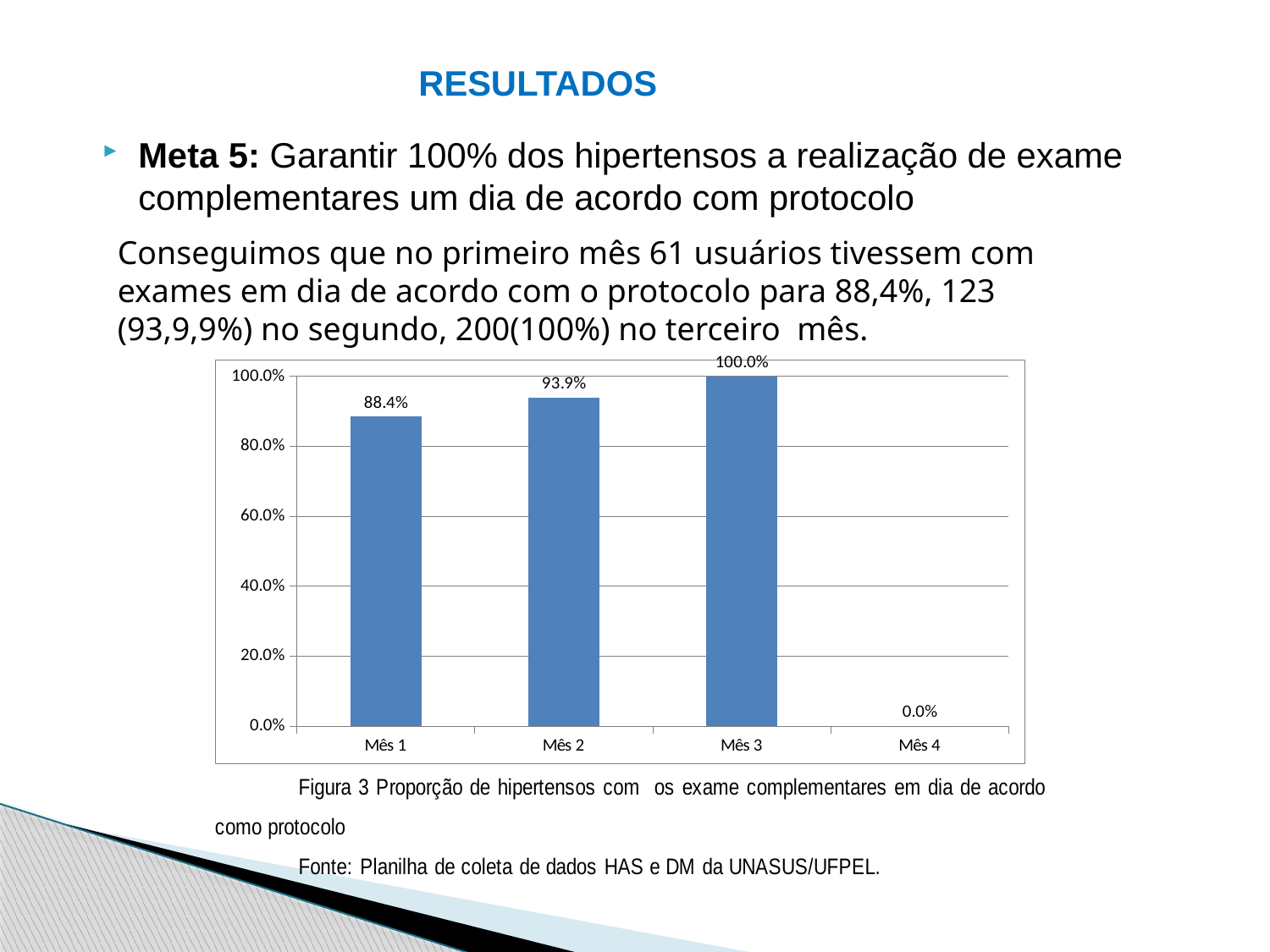
What is the difference between the values for Mês 2 and Mês 1? 5.5% What is the value shown for Mês 1? 88.4% How many months (categories) are shown on the x axis of the chart? 4 What kind of chart is shown on the slide? Bar chart Do the values rise or fall from Mês 1 to Mês 3? Rise What is the value shown for Mês 3? 100.0% What is the difference between the values for Mês 3 and Mês 2? 6.1% What is the value shown for Mês 4? 0.0% Which month has the lowest value in the chart? Mês 4 What is the value shown for Mês 2? 93.9% Which month has the highest value in the chart? Mês 3 Which is larger, the value for Mês 1 or the value for Mês 2? Mês 2